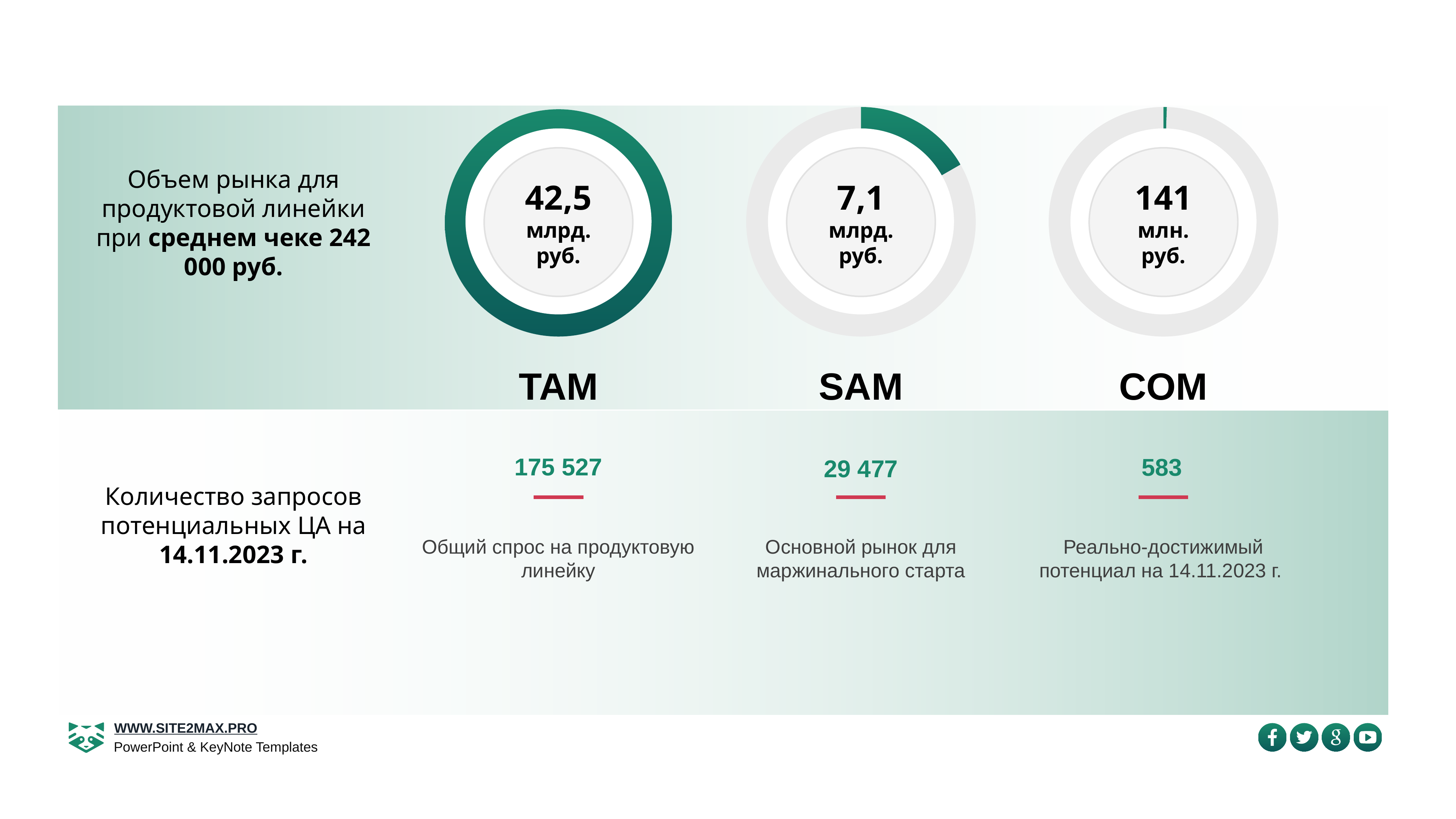
What is the market volume shown in the SAM ring chart? 7,1 млрд. руб. Which is larger: the number of requests under the SAM chart or under the COM chart? SAM Which of the three ring charts (TAM, SAM, COM) shows the largest market volume? TAM What is the market volume shown in the TAM ring chart? 42,5 млрд. руб. What is the market volume shown in the COM ring chart? 141 млн. руб. What is the number of requests from the potential target audience shown under the TAM chart? 175 527 What is the number of requests from the potential target audience shown under the SAM chart? 29 477 Which of the three ring charts (TAM, SAM, COM) shows the smallest market volume? COM What is the number of requests from the potential target audience shown under the COM chart? 583 How many ring charts are shown on the slide? 3 What is the difference in market volume between the TAM and SAM ring charts? 35,4 млрд. руб. What kind of charts are used to show TAM, SAM and COM on the slide? Ring (donut) charts